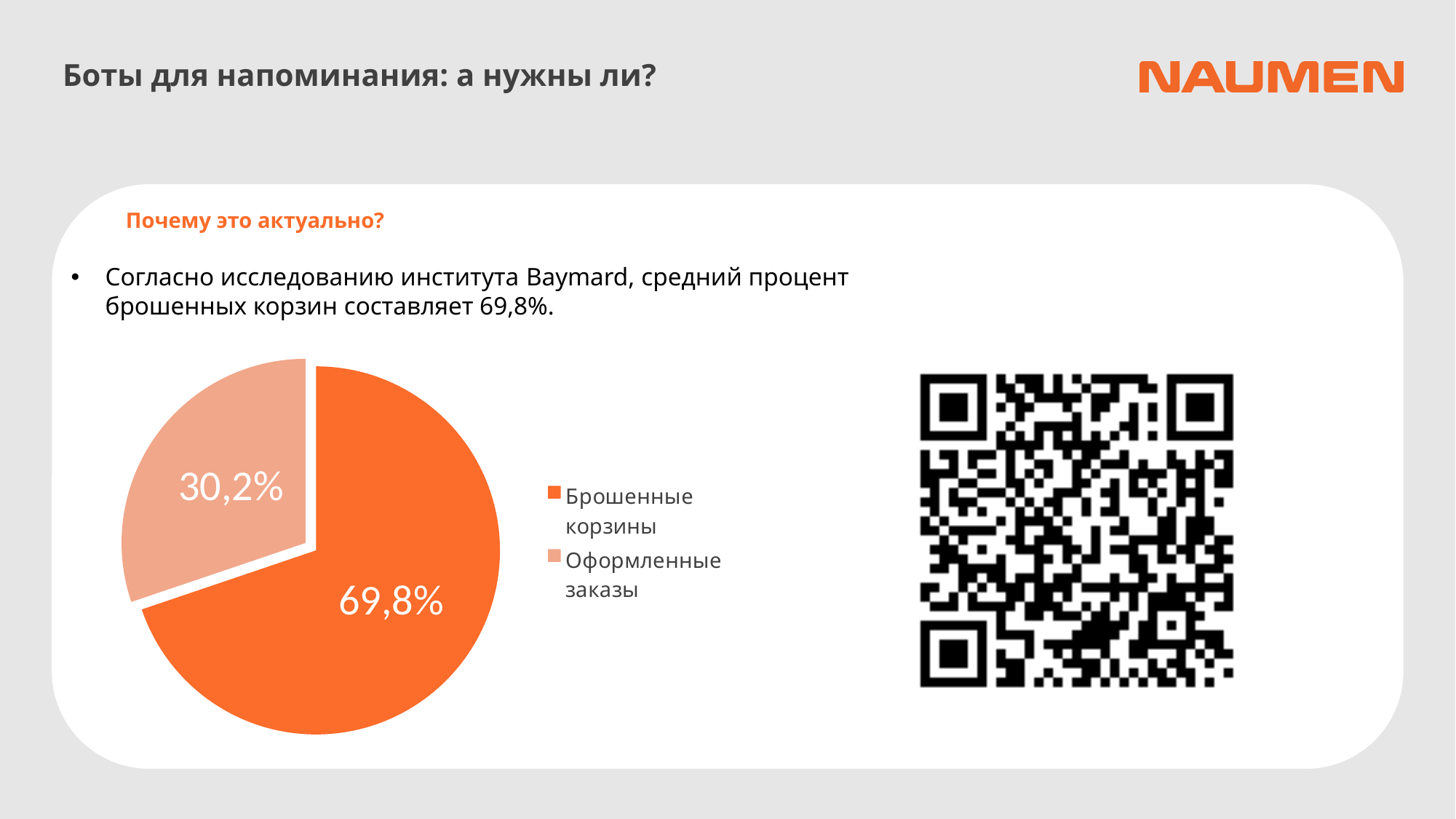
Which is larger: Брошенные корзины or Оформленные заказы? Брошенные корзины What is the value for Брошенные корзины? 69,8% Which slice of the pie is the smallest? Оформленные заказы What is the difference between the values for Брошенные корзины and Оформленные заказы? 39,6% What is the value for Оформленные заказы? 30,2% Which legend entry is shown in the darker orange colour? Брошенные корзины How many entries does the legend list? 2 What share of the pie does Оформленные заказы take? 30,2% Is the value for Брошенные корзины greater or less than 50%? greater How many slices does the pie chart have? 2 What kind of chart is shown on the slide? pie chart Which slice of the pie is the largest? Брошенные корзины